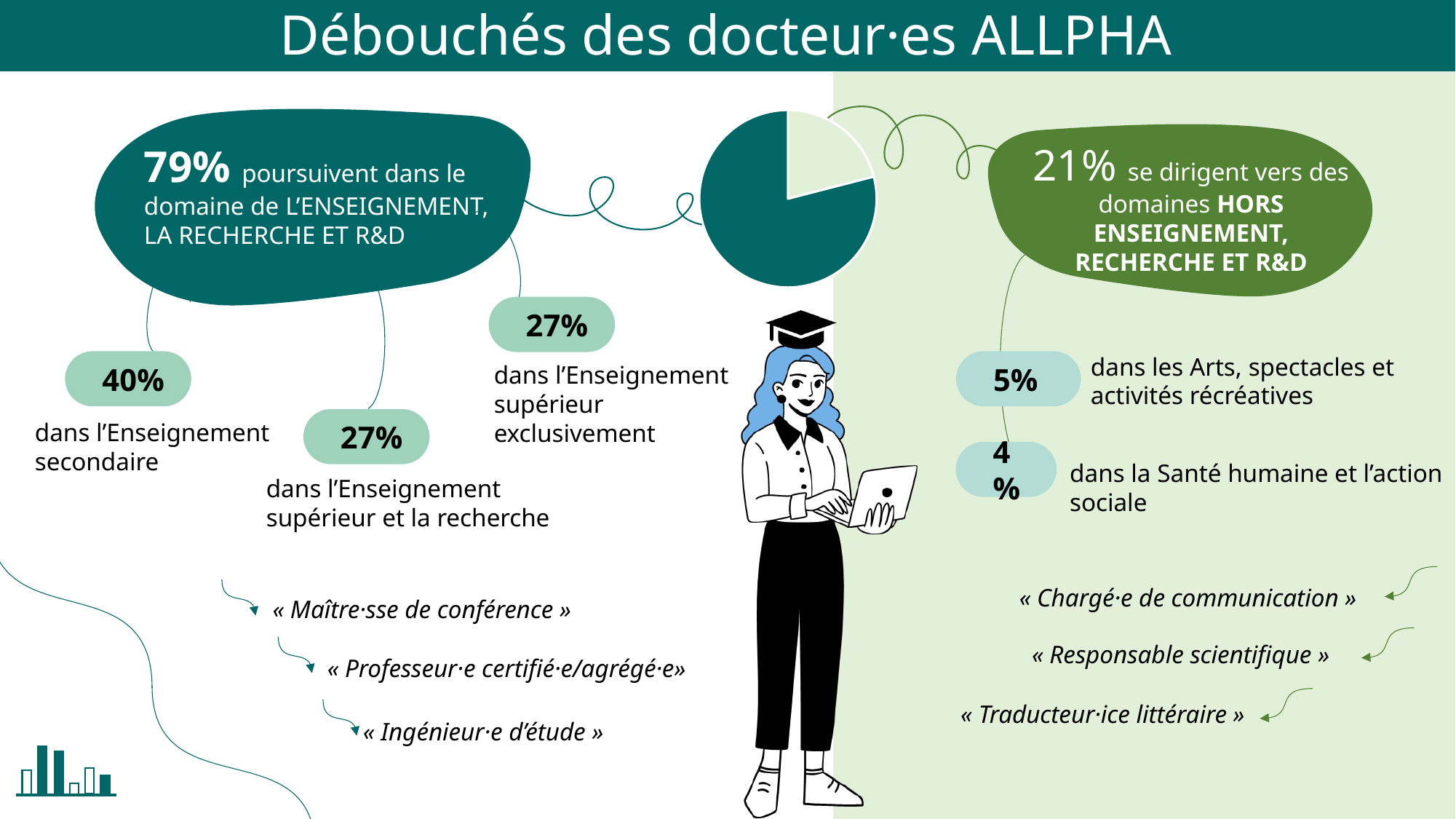
What colour is the larger slice of the pie chart? dark teal What kind of chart is shown in the centre of the slide? pie chart What share of the pie chart does the dark teal slice (enseignement, recherche et R&D) represent? 79% Which is larger in the pie chart: the share going into enseignement, recherche et R&D, or the share going outside those domains? Enseignement, recherche et R&D What share of the pie chart does the light green slice (hors enseignement, recherche et R&D) represent? 21% Which slice of the pie chart is the largest? Enseignement, recherche et R&D (79%) What is the title of the slide containing the pie chart? Débouchés des docteur·es ALLPHA Which slice of the pie chart is the smallest? Hors enseignement, recherche et R&D (21%) Is the dark teal slice of the pie chart greater or less than 50%? greater What do the two slices of the pie chart add up to? 100% How many slices does the pie chart have? 2 What is the difference in percentage points between the two slices of the pie chart? 58